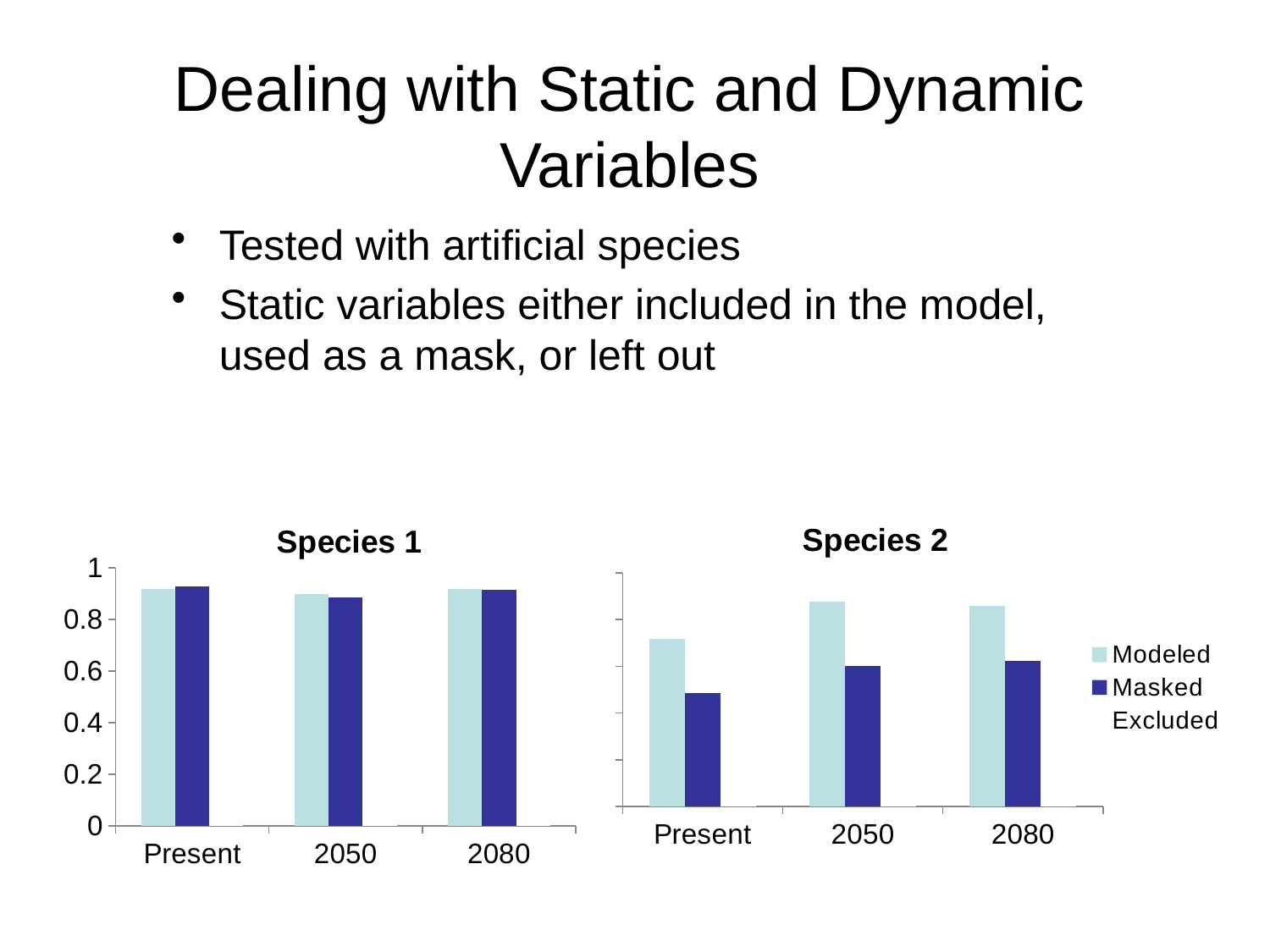
What is the title of the chart on the left of the slide? Species 1 In the Species 1 chart, is the Modeled value for Present greater or less than 0.8? greater In the Species 2 chart, which is larger for 2080, the Modeled value or the Masked value? Modeled Which legend entry is shown with the dark blue colour? Masked What kind of chart is the Species 1 chart? bar chart How many categories are shown on the x axis of the Species 2 chart? 3 In the Species 2 chart, does the Masked value rise or fall from Present to 2050? rise In the Species 2 chart, which category has the lowest Masked value? Present In the Species 1 chart, is the Masked value for 2050 greater or less than 0.8? greater In the Species 2 chart, which category has the lowest Modeled value? Present In the Species 2 chart, which is larger for Present, the Modeled value or the Masked value? Modeled In the Species 1 chart, is the Modeled value for 2080 greater or less than 0.6? greater